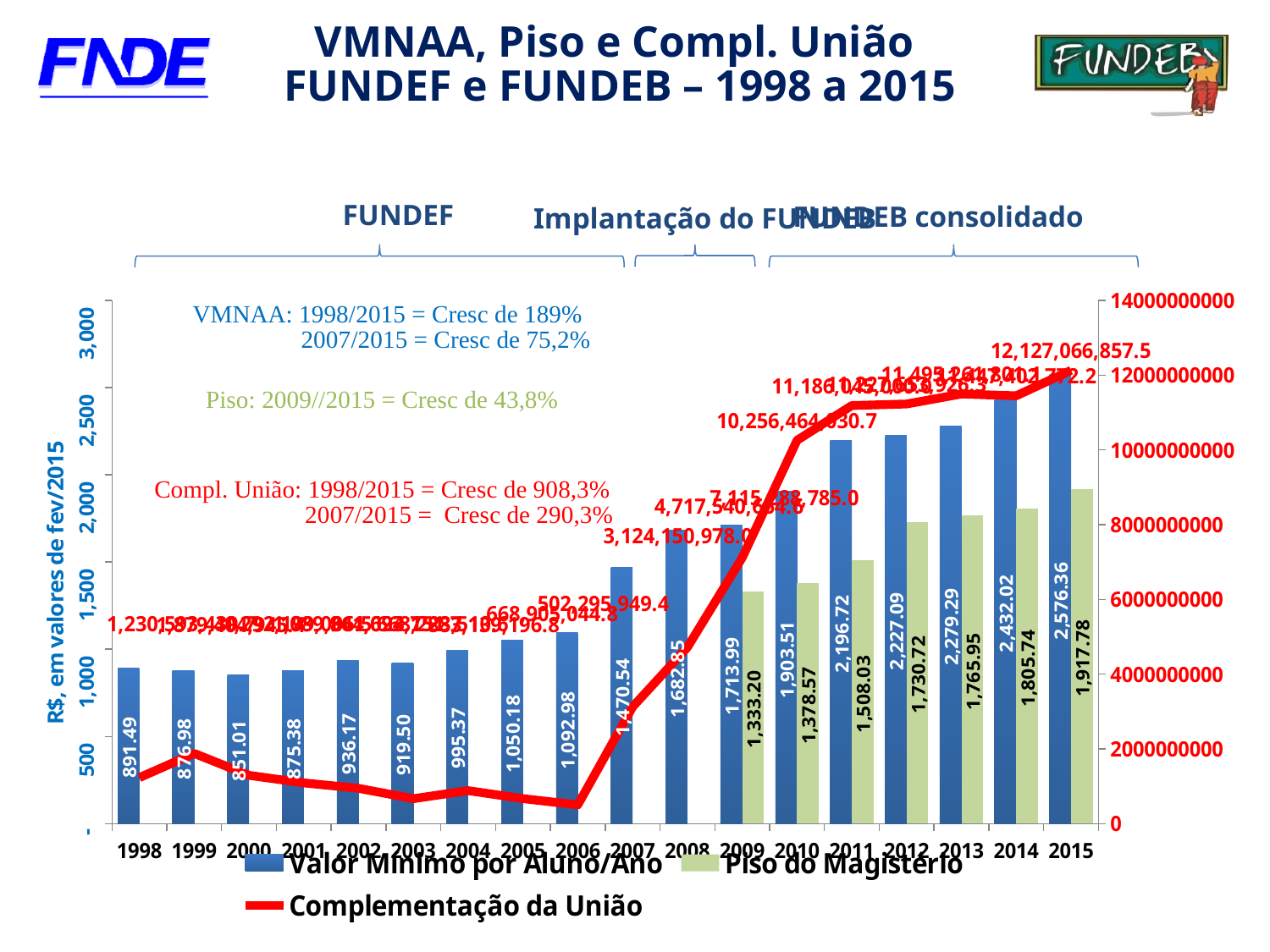
In which year is Valor Mínimo por Aluno/Ano highest? 2015 What is the difference between Piso do Magistério in 2015 and in 2009? 584.58 In which year is Valor Mínimo por Aluno/Ano lowest? 2000 What is the value of Valor Mínimo por Aluno/Ano for 1998? 891.49 What is the value of Valor Mínimo por Aluno/Ano for 2015? 2,576.36 What is the value of Piso do Magistério for 2012? 1,730.72 Does Piso do Magistério rise or fall from 2009 to 2015? rise What is the difference between Valor Mínimo por Aluno/Ano in 2015 and in 2014? 144.34 What is the value of Complementação da União for 2015? 12,127,066,857.5 How many series does the legend list? 3 How many years are shown on the x axis? 18 Which year has the larger Valor Mínimo por Aluno/Ano, 2002 or 2003? 2002